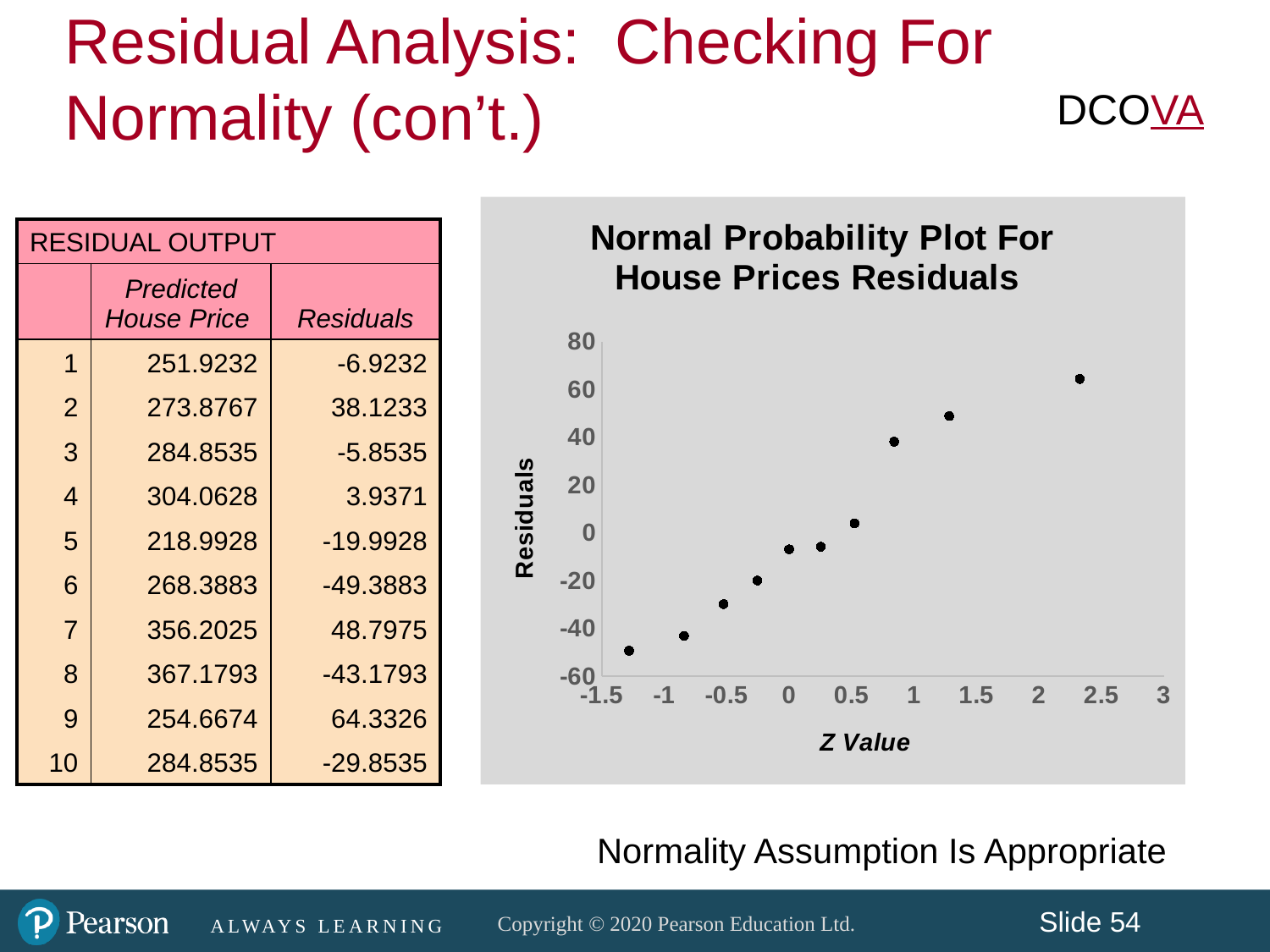
In the Normal Probability Plot For House Prices Residuals, is the residual of the highest point greater or less than 40? greater How many points in the Normal Probability Plot For House Prices Residuals have a residual above 0? 4 What kind of chart is the Normal Probability Plot For House Prices Residuals? scatter plot How many points in the Normal Probability Plot For House Prices Residuals have a residual below 0? 6 What is the title of the chart on the slide? Normal Probability Plot For House Prices Residuals How many points are plotted in the Normal Probability Plot For House Prices Residuals? 10 In the Normal Probability Plot For House Prices Residuals, is the residual of the point with the largest Z Value greater or less than 20? greater What is the label on the horizontal axis of the Normal Probability Plot For House Prices Residuals? Z Value In the Normal Probability Plot For House Prices Residuals, is the residual of the point with the smallest Z Value greater or less than -20? less In the Normal Probability Plot For House Prices Residuals, do the residuals rise or fall as the Z Value increases? rise